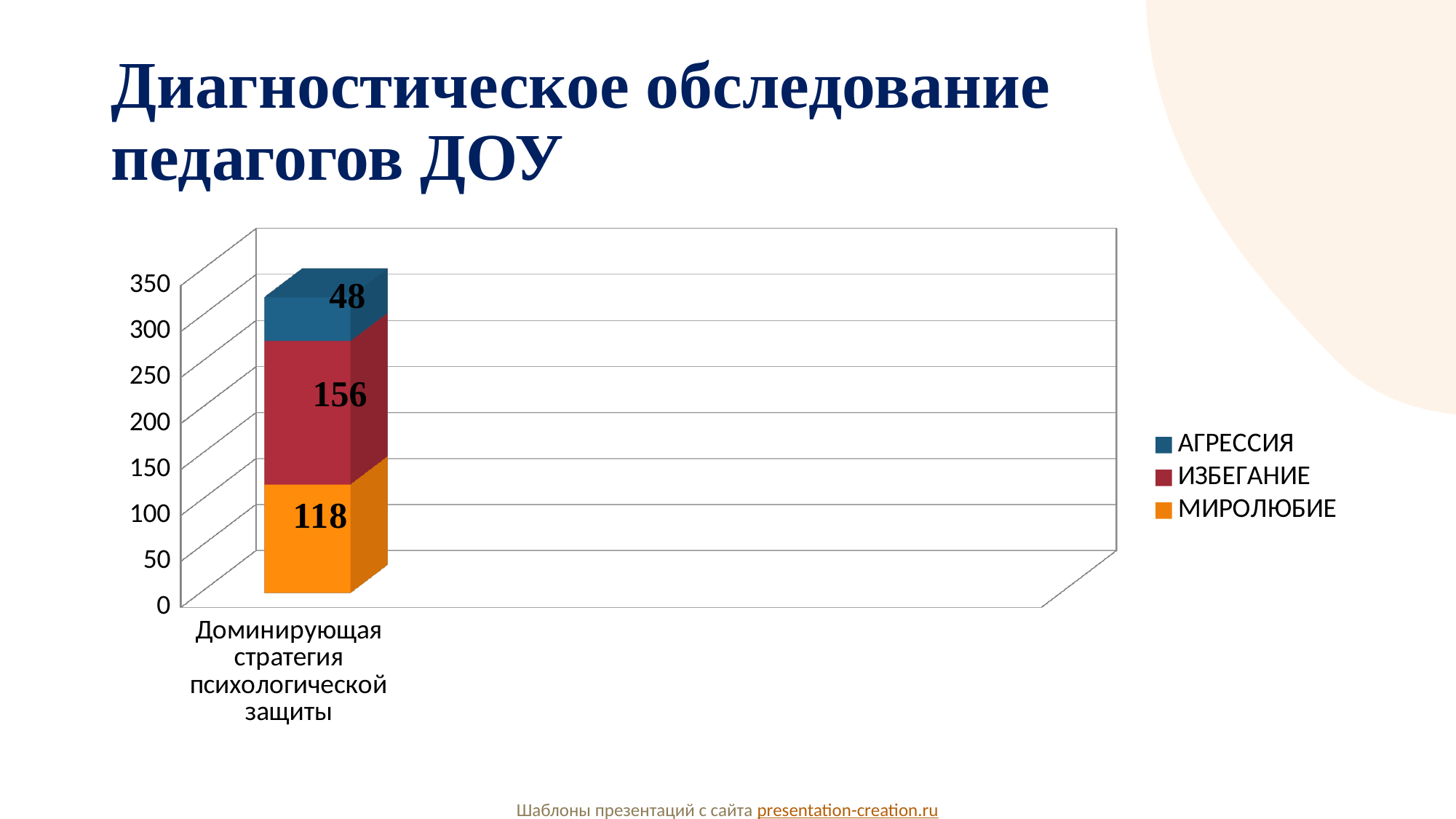
Which series has the lowest value in the stacked bar? АГРЕССИЯ How many series does the legend list? 3 What is the difference between the values for МИРОЛЮБИЕ and АГРЕССИЯ? 70 What is the value for ИЗБЕГАНИЕ in the stacked bar? 156 Which series has the highest value in the stacked bar? ИЗБЕГАНИЕ What kind of chart is shown on the slide? Stacked bar chart What is the difference between the values for ИЗБЕГАНИЕ and МИРОЛЮБИЕ? 38 Which is larger, the value for МИРОЛЮБИЕ or the value for АГРЕССИЯ? МИРОЛЮБИЕ How many categories are shown on the x axis? 1 What is the value for МИРОЛЮБИЕ in the stacked bar? 118 What is the value for АГРЕССИЯ in the stacked bar? 48 What is the total of the stacked bar for Доминирующая стратегия психологической защиты? 322